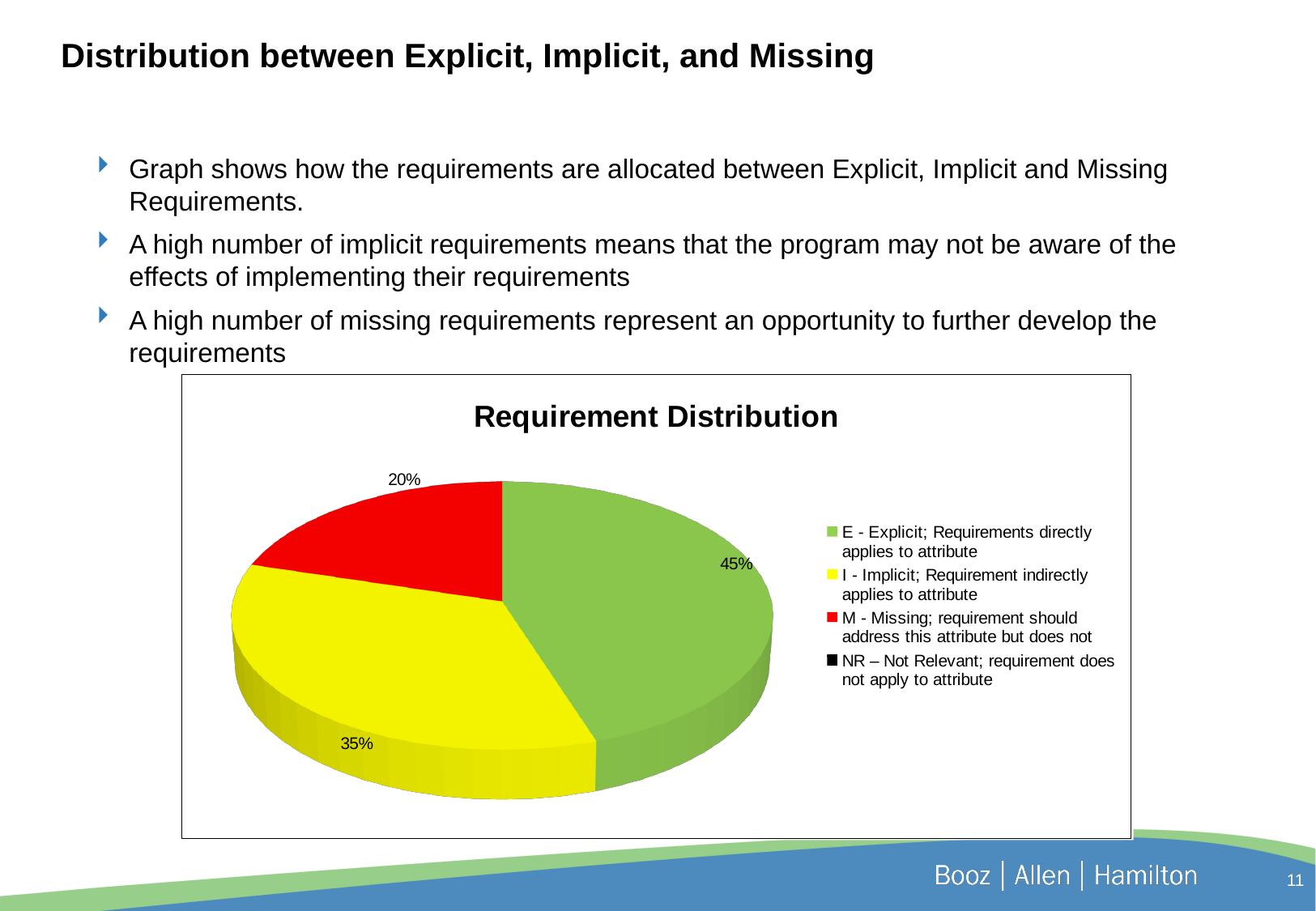
What is the difference in percentage points between the Implicit and Missing slices? 15% Which of the visible slices is the smallest? M - Missing What kind of chart is shown on the slide? pie chart What share of the pie is the Missing (M) slice? 20% Which category has the largest slice of the pie? E - Explicit What colour is the Missing (M) slice? red What share of the pie is the Explicit (E) slice? 45% What is the title of the chart? Requirement Distribution How many entries does the legend list? 4 What is the difference in percentage points between the Explicit and Implicit slices? 10% What share of the pie is the Implicit (I) slice? 35% Which is larger, the Implicit slice or the Missing slice? Implicit